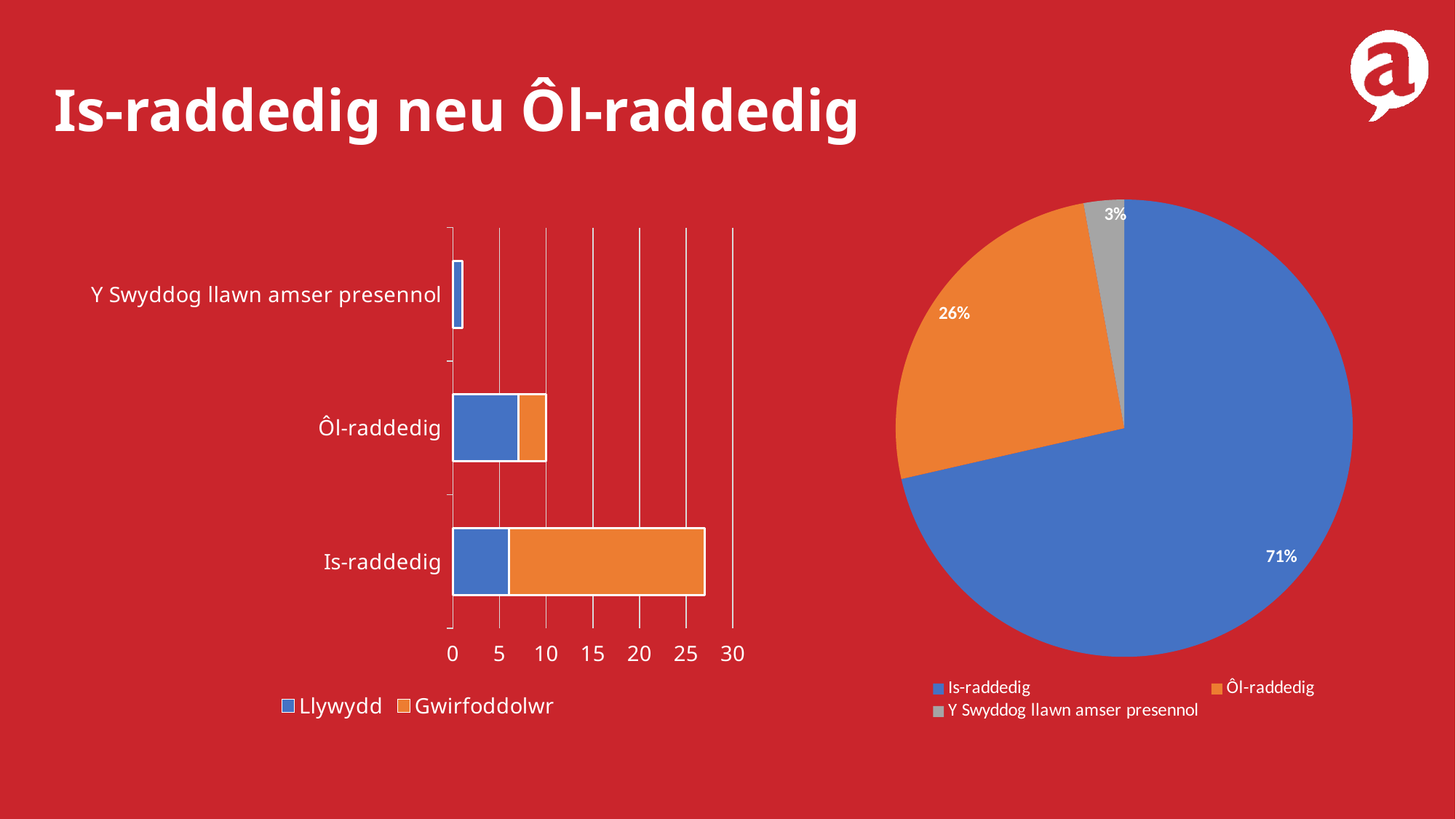
In the pie chart on the right, what percentage is shown for Is-raddedig? 71% In the bar chart on the left, which category has the longest bar overall? Is-raddedig In the bar chart on the left, is the total length of the Is-raddedig bar greater or less than 20? greater In the pie chart on the right, what percentage is shown for Ôl-raddedig? 26% What kind of chart is the chart on the left of the slide? Bar chart In the pie chart on the right, what is the difference in percentage points between the Is-raddedig slice and the Ôl-raddedig slice? 45 percentage points In the pie chart on the right, which category has the largest slice? Is-raddedig In the bar chart on the left, is the total length of the Ôl-raddedig bar greater or less than 15? less How many slices does the pie chart on the right have? 3 In the pie chart on the right, what percentage is shown for Y Swyddog llawn amser presennol? 3% How many series does the legend of the bar chart on the left list? 2 In the pie chart on the right, which category has the smallest slice? Y Swyddog llawn amser presennol